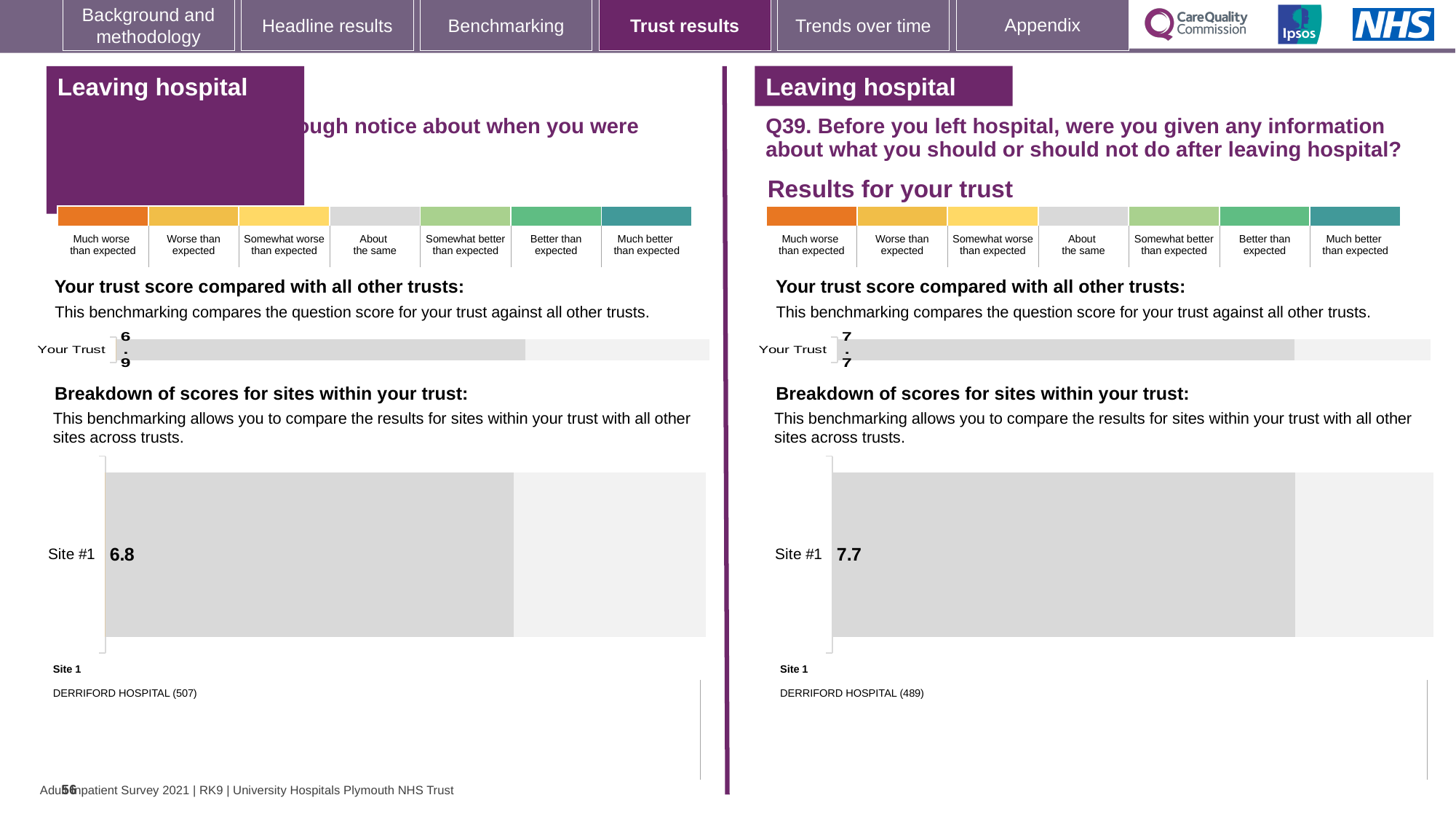
Which site is listed as Site 1 below the breakdown chart on the right-hand side of the slide (Q39)? DERRIFORD HOSPITAL (489) On the right-hand side of the slide (Q39), what score is shown for Site #1 in the breakdown of scores for sites chart? 7.7 Which site is listed as Site 1 below the breakdown chart on the left-hand side of the slide? DERRIFORD HOSPITAL (507) On the left-hand side of the slide, what is the difference between the Your Trust score and the Site #1 score? 0.1 What is the difference between the Site #1 score on the right-hand side (Q39) and the Site #1 score on the left-hand side of the slide? 0.9 How many sites are shown in the breakdown of scores for sites chart on the right-hand side of the slide (Q39)? 1 On the left-hand side of the slide, what is the score shown for Your Trust in the 'Your trust score compared with all other trusts' chart? 6.9 On the left-hand side of the slide, what score is shown for Site #1 in the breakdown of scores for sites chart? 6.8 Which is larger: the Your Trust score on the left-hand side of the slide or the Your Trust score on the right-hand side (Q39)? Right-hand side (Q39), 7.7 What kind of chart is used to show the Site #1 score on the left-hand side of the slide? Bar chart On the right-hand side of the slide (Q39), what is the score shown for Your Trust in the 'Your trust score compared with all other trusts' chart? 7.7 How many categories are shown in the coloured benchmarking scale on the right-hand side of the slide (Q39)? 7